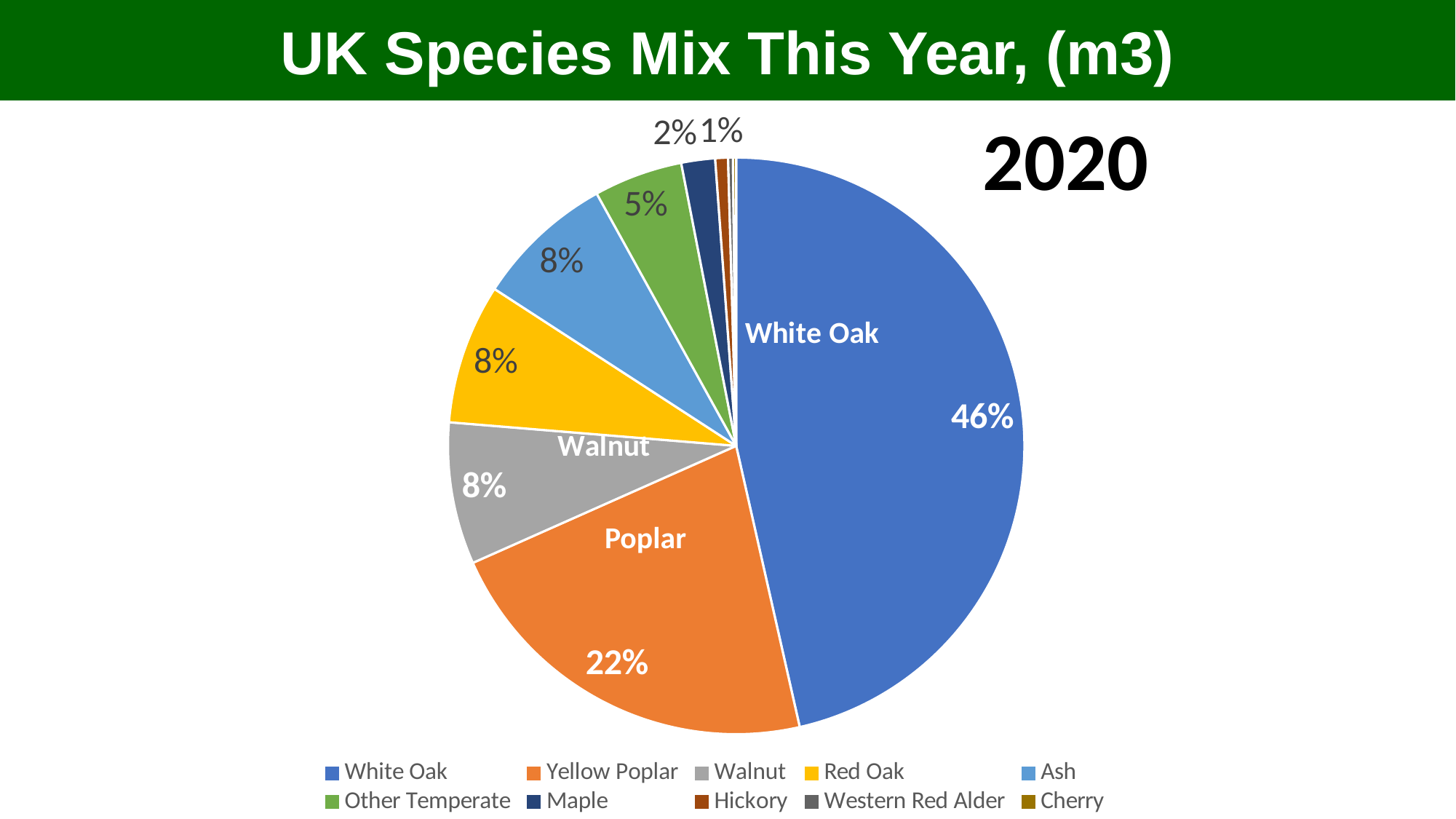
What percentage is shown for the Poplar (Yellow Poplar) slice? 22% What percentage is shown for the Walnut slice? 8% How many percentage points larger is the White Oak slice than the Poplar slice? 24 What is the title of the chart? UK Species Mix This Year, (m3) What percentage is shown for the Maple slice? 2% What percentage is shown for the Hickory slice? 1% Which species has the largest slice of the pie? White Oak How many species are listed in the legend? 10 What percentage is shown for the Other Temperate slice? 5% What kind of chart is shown on the slide? pie chart Which slice is larger, Yellow Poplar or Other Temperate? Yellow Poplar What share of the pie does White Oak account for? 46%